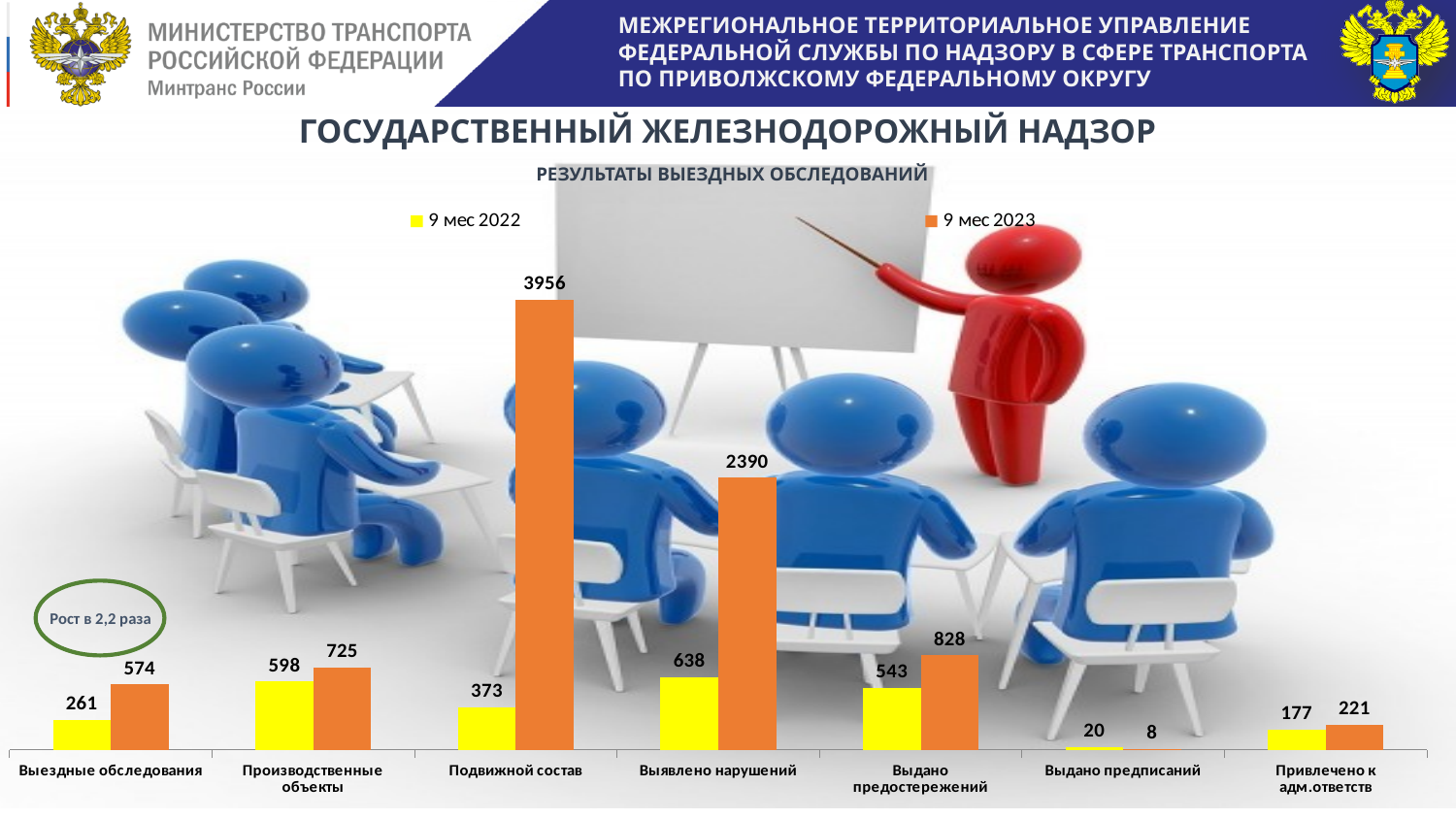
For Выдано предписаний, which series has the larger value: 9 мес 2022 or 9 мес 2023? 9 мес 2022 How many series does the legend list? 2 What is the value for Выездные обследования in the 9 мес 2022 series? 261 What is the value for Выдано предписаний in the 9 мес 2023 series? 8 What is the difference between the 9 мес 2023 and 9 мес 2022 values for Выявлено нарушений? 1752 Which category has the highest value in the 9 мес 2023 series? Подвижной состав What type of chart is shown on the slide? Bar chart Which colour represents the 9 мес 2022 series? Yellow What is the value for Подвижной состав in the 9 мес 2023 series? 3956 Which category has the lowest value in the 9 мес 2022 series? Выдано предписаний What is the title of the chart? РЕЗУЛЬТАТЫ ВЫЕЗДНЫХ ОБСЛЕДОВАНИЙ How many categories are shown on the x axis of the chart? 7